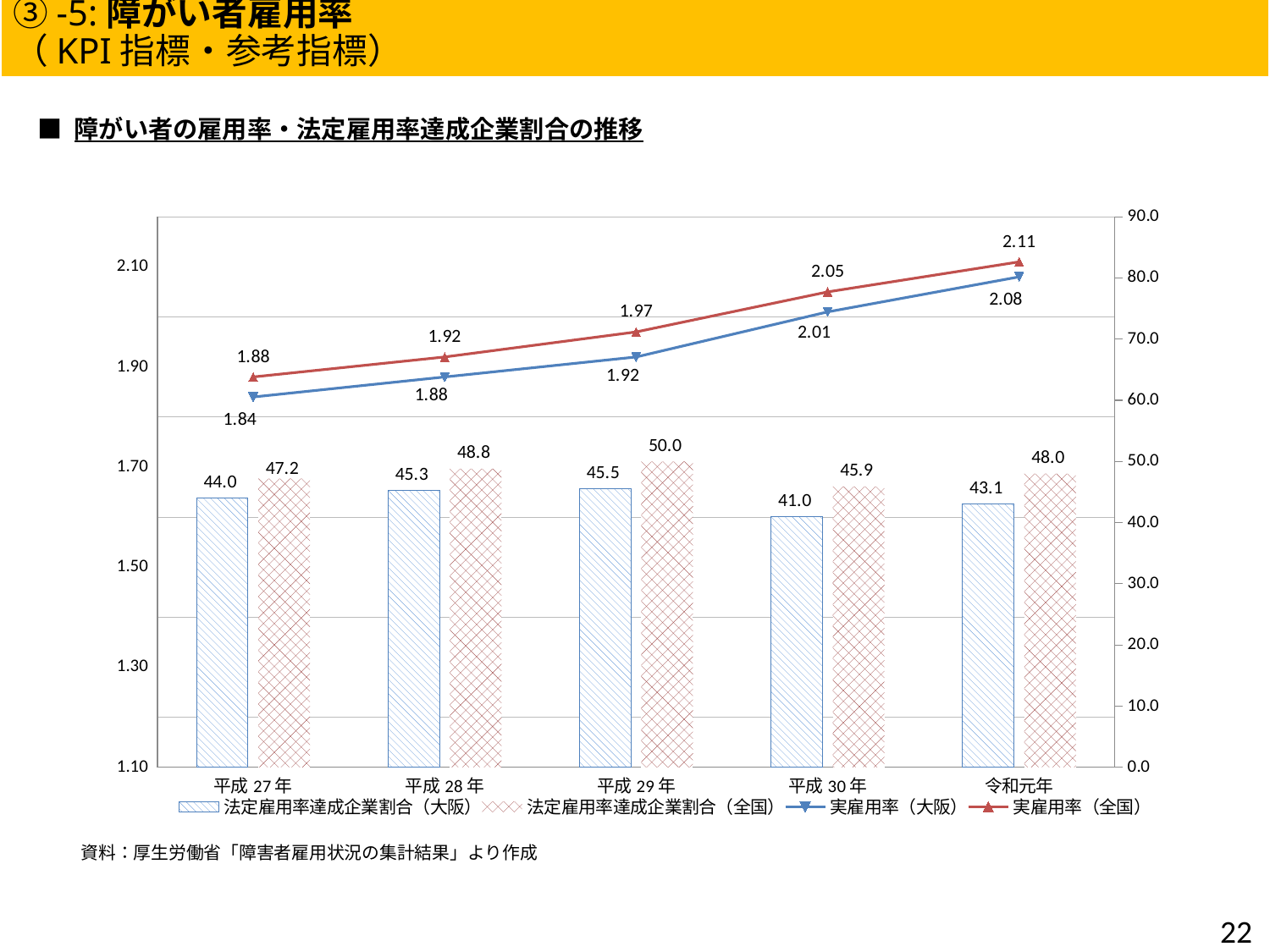
What kind of chart is shown on the slide? A combined bar and line chart What is the value of 実雇用率（大阪） for 令和元年? 2.08 In which year is 法定雇用率達成企業割合（大阪） lowest? 平成30年 What is the difference between 実雇用率（全国） and 実雇用率（大阪） in 平成29年? 0.05 What is the value of 法定雇用率達成企業割合（全国） for 平成29年? 50.0 How many series does the legend list? 4 What is the difference between 法定雇用率達成企業割合（全国） and 法定雇用率達成企業割合（大阪） in 平成30年? 4.9 Does 実雇用率（大阪） rise or fall from 平成27年 to 令和元年? rise In which year is 実雇用率（全国） highest? 令和元年 What is the value of 実雇用率（全国） for 平成27年? 1.88 Which is larger in 平成28年: 法定雇用率達成企業割合（大阪） or 法定雇用率達成企業割合（全国）? 法定雇用率達成企業割合（全国） How many years are shown on the x axis? 5